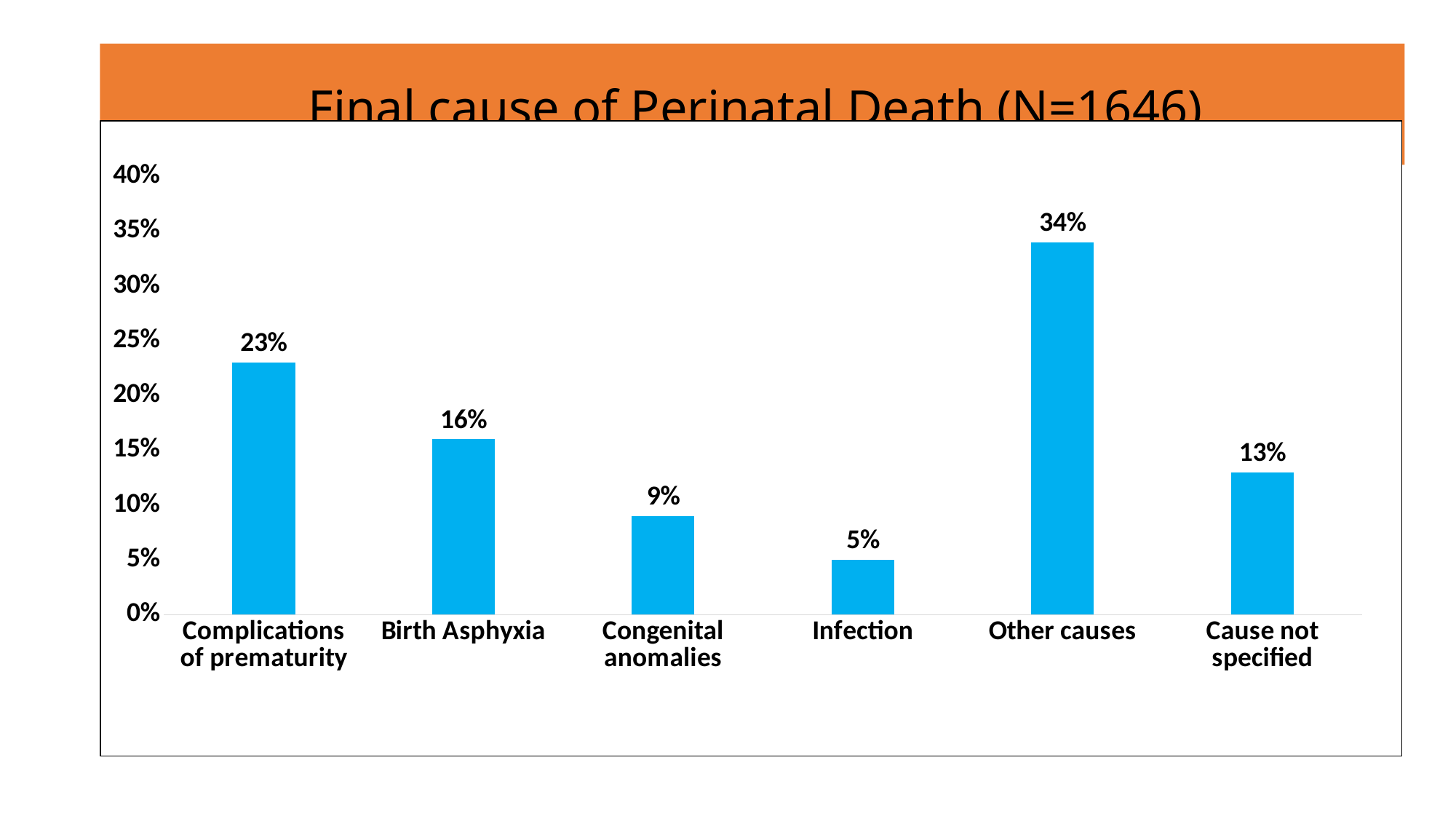
What is the value for Complications of prematurity? 23% Which is larger, the value for Congenital anomalies or the value for Cause not specified? Cause not specified What is the value for Birth Asphyxia? 16% What is the value for Cause not specified? 13% What is the difference between the values for Birth Asphyxia and Congenital anomalies? 7% Which category has the highest value? Other causes What is the difference between the values for Other causes and Complications of prematurity? 11% What is the value for Infection? 5% Which category has the lowest value? Infection How many categories are shown on the x axis? 6 What kind of chart is shown on the slide? Bar chart What is the title of the chart? Final cause of Perinatal Death (N=1646)